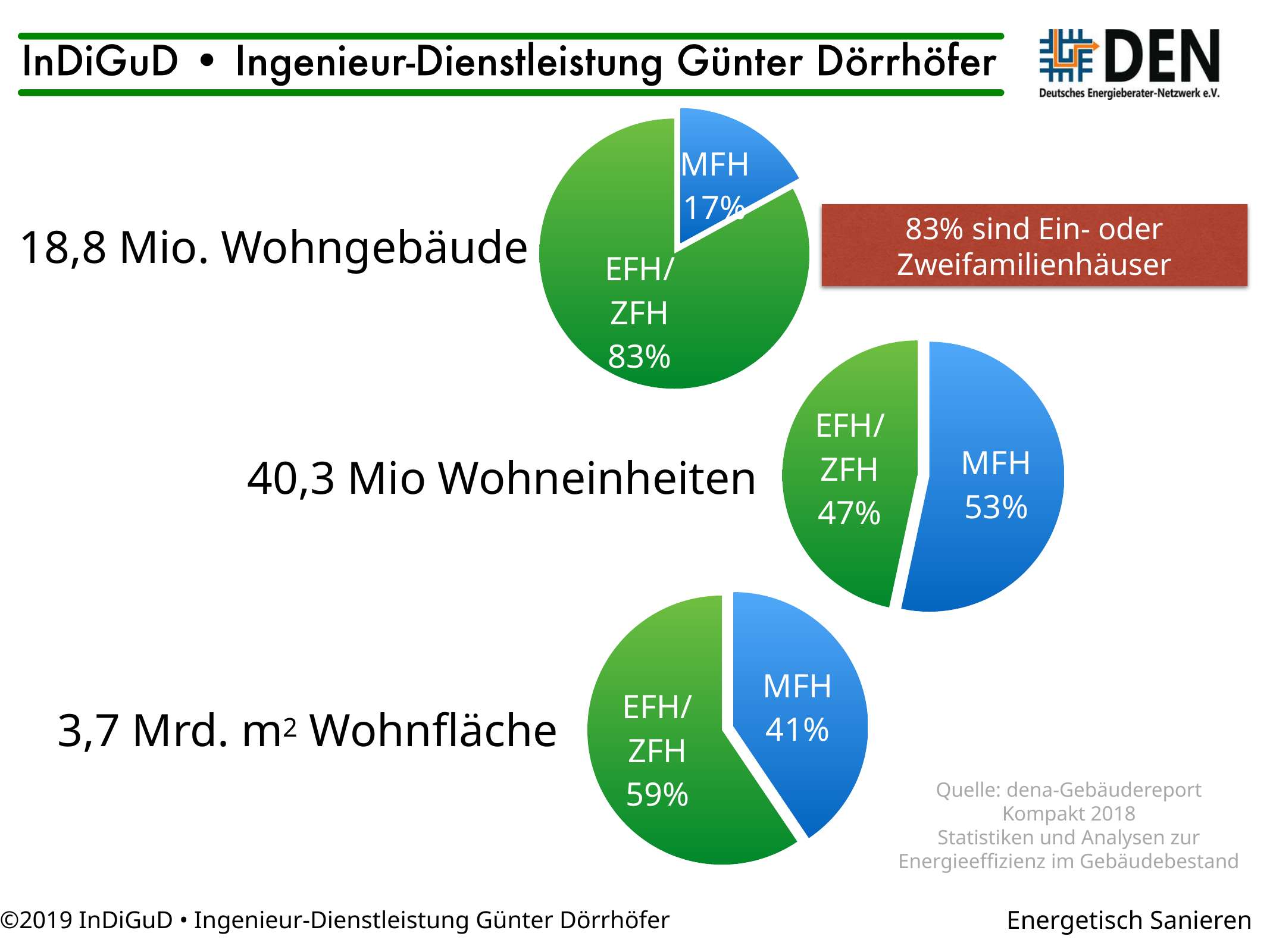
In the top pie chart (Wohngebäude), which slice is the largest? EFH/ZFH In the bottom pie chart (next to "3,7 Mrd. m² Wohnfläche"), what share is labelled for EFH/ZFH? 59% In the middle pie chart (next to "40,3 Mio Wohneinheiten"), what share is labelled for MFH? 53% In the middle pie chart (next to "40,3 Mio Wohneinheiten"), what share is labelled for EFH/ZFH? 47% What kind of chart is used on this slide? Pie chart In the top pie chart (next to "18,8 Mio. Wohngebäude"), what share is labelled for EFH/ZFH? 83% In the top pie chart (next to "18,8 Mio. Wohngebäude"), what share is labelled for MFH? 17% In the top pie chart (Wohngebäude), what is the difference in percentage points between the EFH/ZFH and MFH slices? 66 How many pie charts are shown on the slide? 3 In the bottom pie chart (Wohnfläche), what is the difference in percentage points between the EFH/ZFH and MFH slices? 18 In the bottom pie chart (next to "3,7 Mrd. m² Wohnfläche"), what share is labelled for MFH? 41% In the middle pie chart (Wohneinheiten), which slice is the smallest? EFH/ZFH